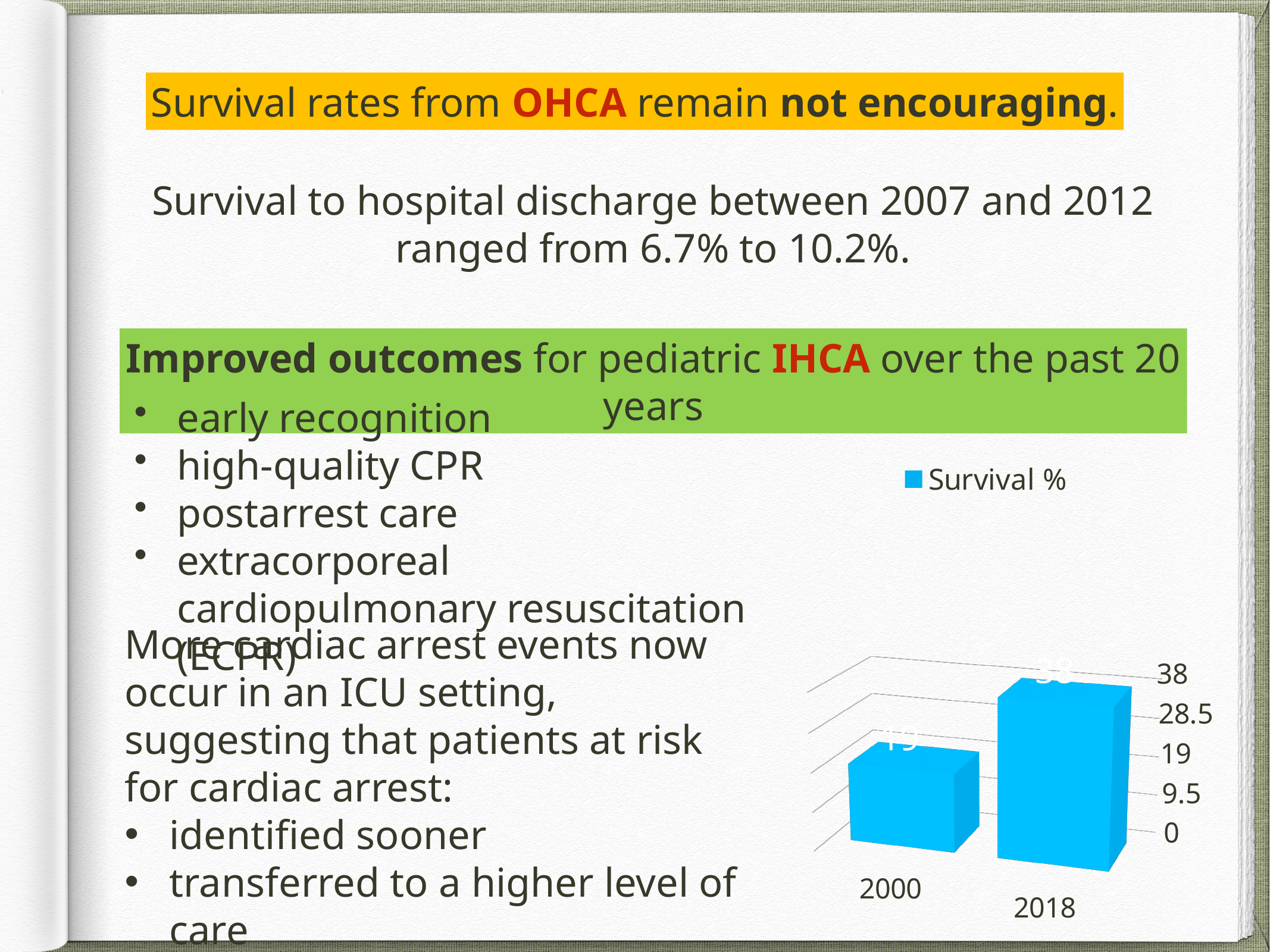
Which year has the lower Survival %? 2000 What is the difference in Survival % between 2018 and 2000? 19 Is the Survival % value for 2000 greater or less than 28.5? less What kind of chart is shown on the slide? bar chart How many years are shown on the chart? 2 Does the Survival % rise or fall from 2000 to 2018? rise How many series does the chart legend list? 1 Is the Survival % for 2018 larger or smaller than for 2000? larger Which year has the higher Survival %? 2018 What is the Survival % value for 2018? 38 What is the name of the series shown in the chart legend? Survival % What is the Survival % value for 2000? 19